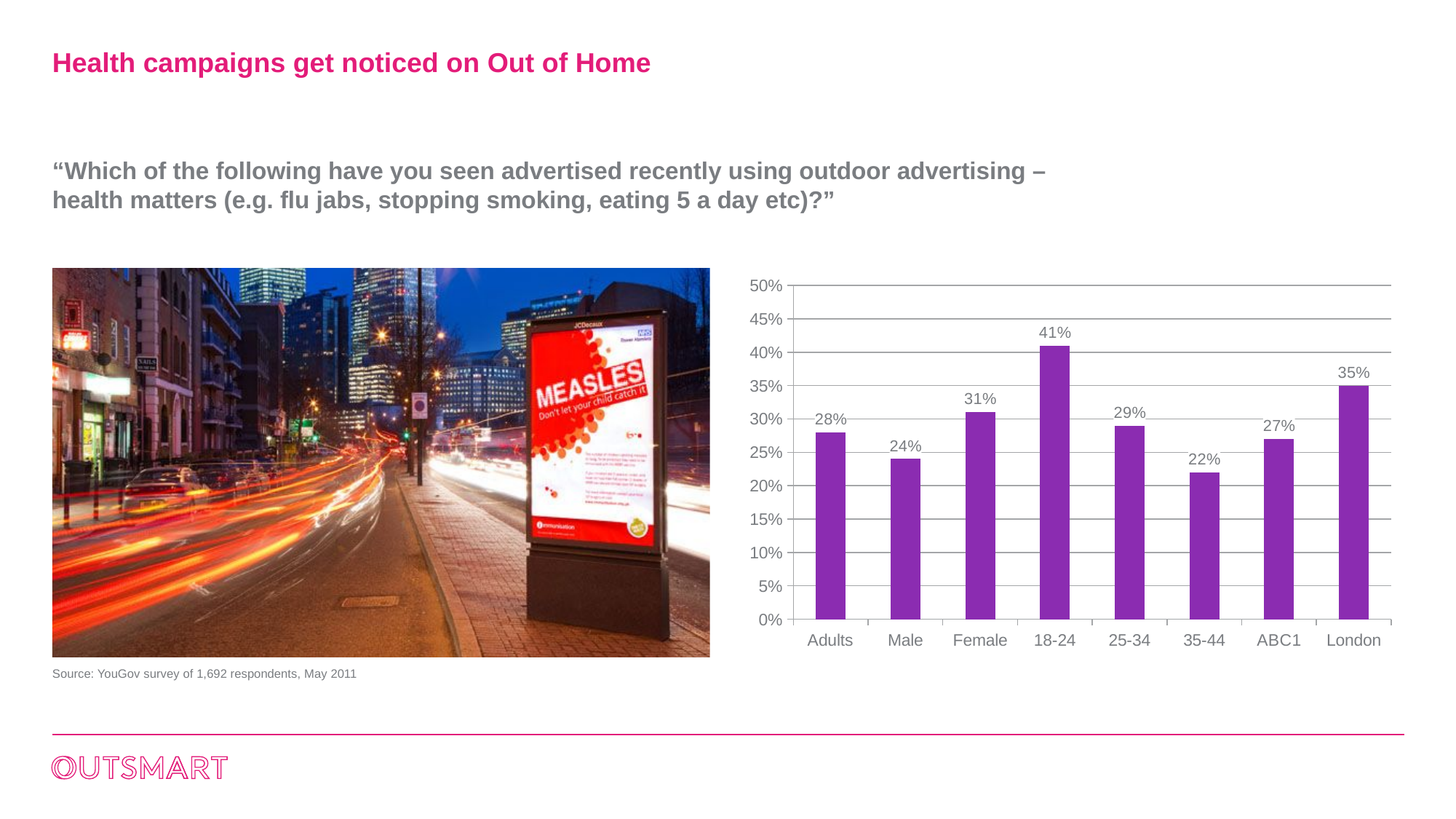
Which is larger, the value for 25-34 or the value for 35-44? 25-34 What is the value for ABC1? 27% What percentage is shown for Adults? 28% What colour are the bars in the chart? purple Is the value for London greater or less than 30%? greater How many categories are shown on the x axis? 8 What type of chart is shown on the slide? bar chart What is the difference between the Female and Male values? 7% What is the value for the 18-24 age group? 41% Which category has the lowest value? 35-44 What percentage is shown for London? 35% Which category has the highest value? 18-24